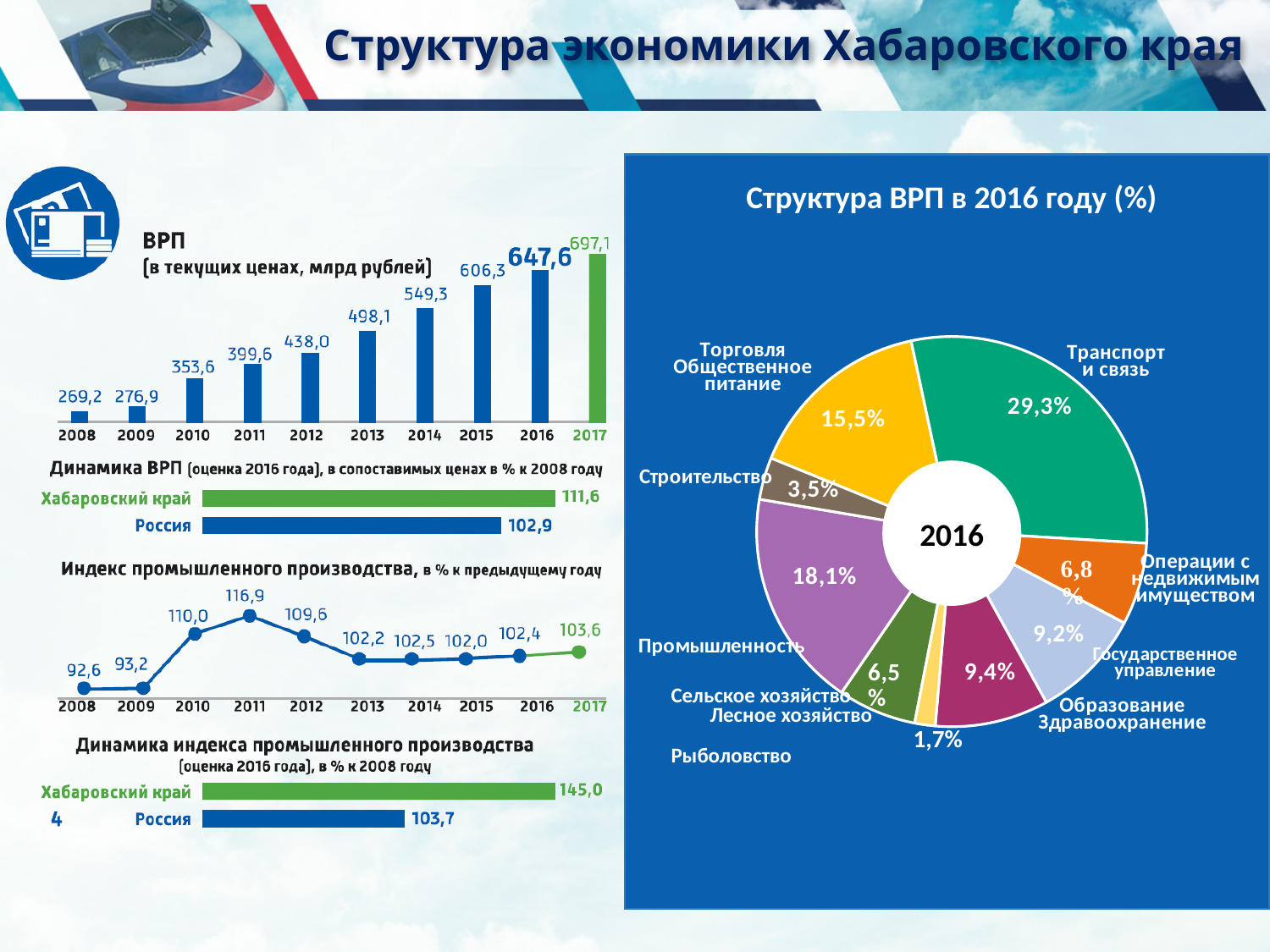
On the Индекс промышленного производства chart, which year has the highest value? 2011 On the ВРП (в текущих ценах, млрд рублей) bar chart, what is the value for 2014? 549,3 What kind of chart is the Индекс промышленного производства chart? line chart On the ВРП (в текущих ценах, млрд рублей) chart, do the values rise or fall from 2008 to 2017? rise How many years are shown on the ВРП (в текущих ценах, млрд рублей) bar chart? 10 On the Динамика ВРП chart, what is the value for Хабаровский край? 111,6 On the Структура ВРП в 2016 году (%) pie chart, what is the share of Промышленность? 18,1% On the ВРП (в текущих ценах, млрд рублей) chart, what is the difference between the 2017 and 2016 values? 49,5 On the Структура ВРП в 2016 году (%) pie chart, which sector has the largest share? Транспорт и связь What kind of chart is the ВРП (в текущих ценах, млрд рублей) chart? bar chart On the Динамика индекса промышленного производства chart, what is the difference between Хабаровский край and Россия? 41,3 On the Индекс промышленного производства chart, which year has the lowest value? 2008